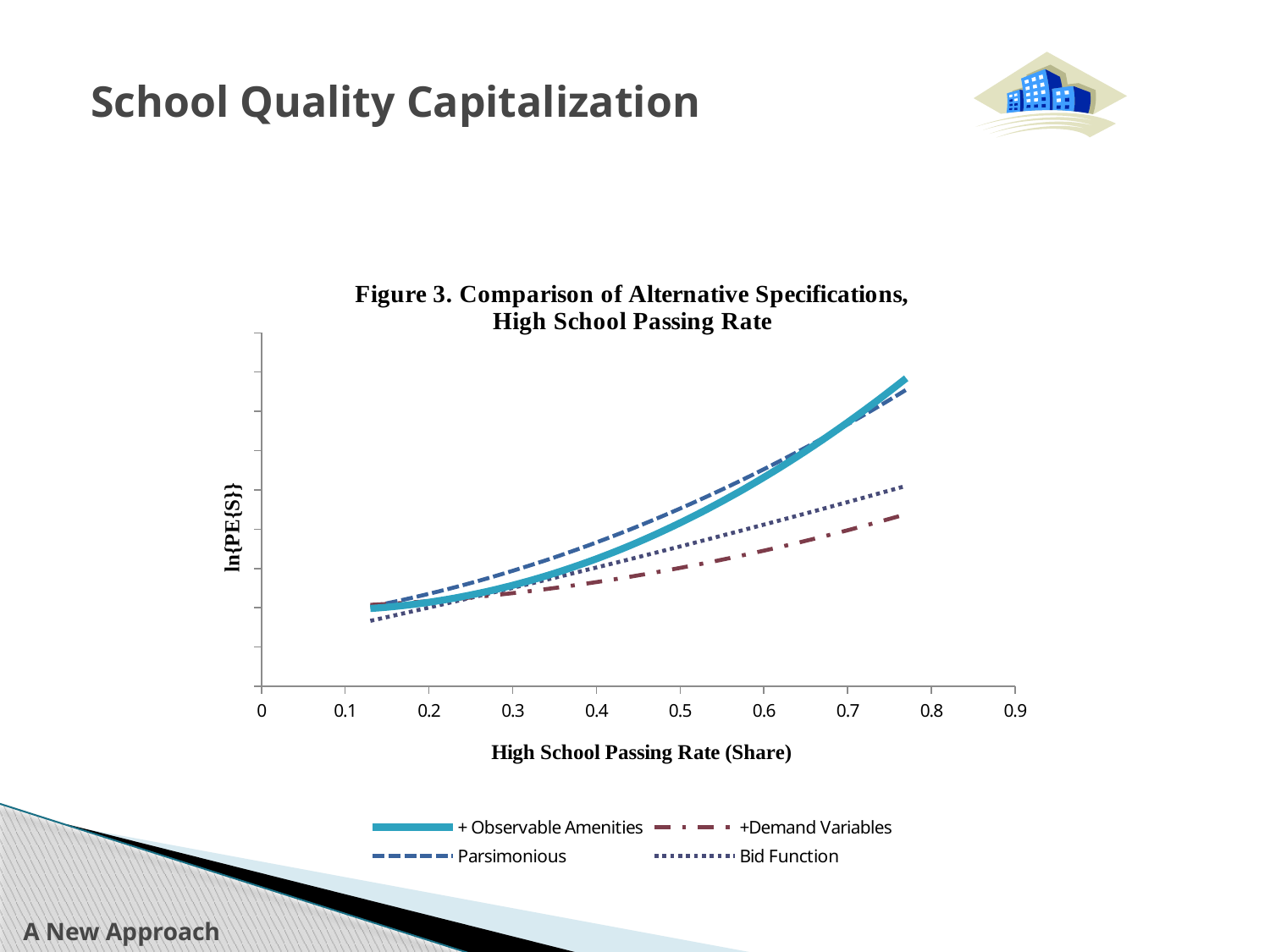
At a High School Passing Rate of 0.7, which is higher: + Observable Amenities or +Demand Variables? + Observable Amenities Do the plotted lines rise or fall as the High School Passing Rate increases? rise What is the label on the x axis of the chart? High School Passing Rate (Share) At a High School Passing Rate of 0.6, which is higher: Parsimonious or Bid Function? Parsimonious What kind of chart is shown in Figure 3? line chart At a High School Passing Rate of 0.7, which is higher: Bid Function or +Demand Variables? Bid Function Which series has the lowest value at a High School Passing Rate of 0.7? +Demand Variables What is the title of the chart? Figure 3. Comparison of Alternative Specifications, High School Passing Rate How many series does the legend of Figure 3 list? 4